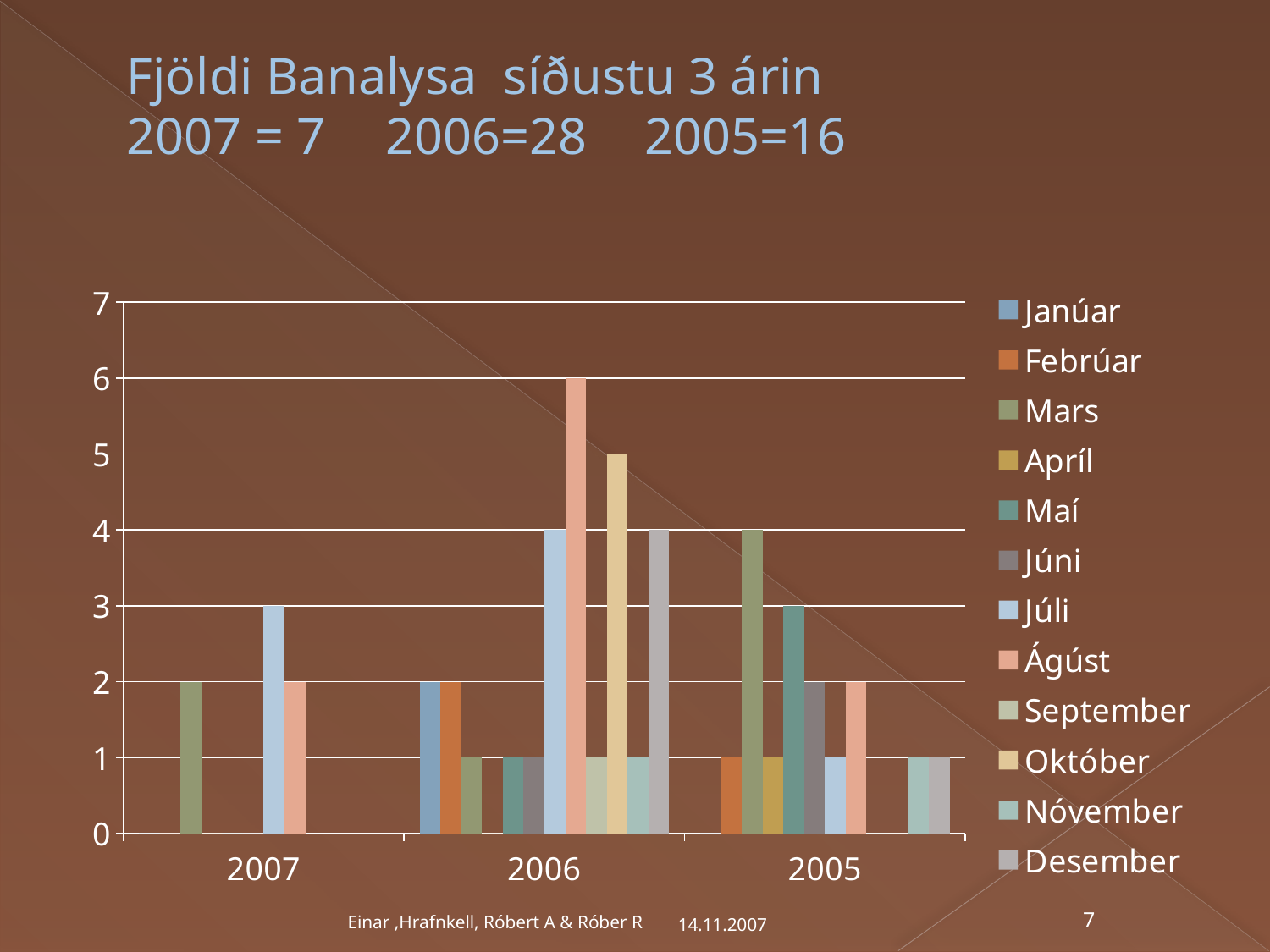
According to the slide title, what is the total number of Banalysa for 2006? 28 Which month has the highest value in 2006? Ágúst What is the value for Júlí in 2007? 3 What kind of chart is shown on the slide? bar chart How many year categories are shown on the x axis? 3 Which month has the highest value in 2005? Mars How many series does the legend list? 12 What is the difference between the Ágúst value in 2006 and the Ágúst value in 2005? 4 What is the value for Ágúst in 2006? 6 In 2006, which is larger: Október or Desember? Október What is the value for Maí in 2005? 3 Is the value for Október in 2006 greater or less than 4? greater